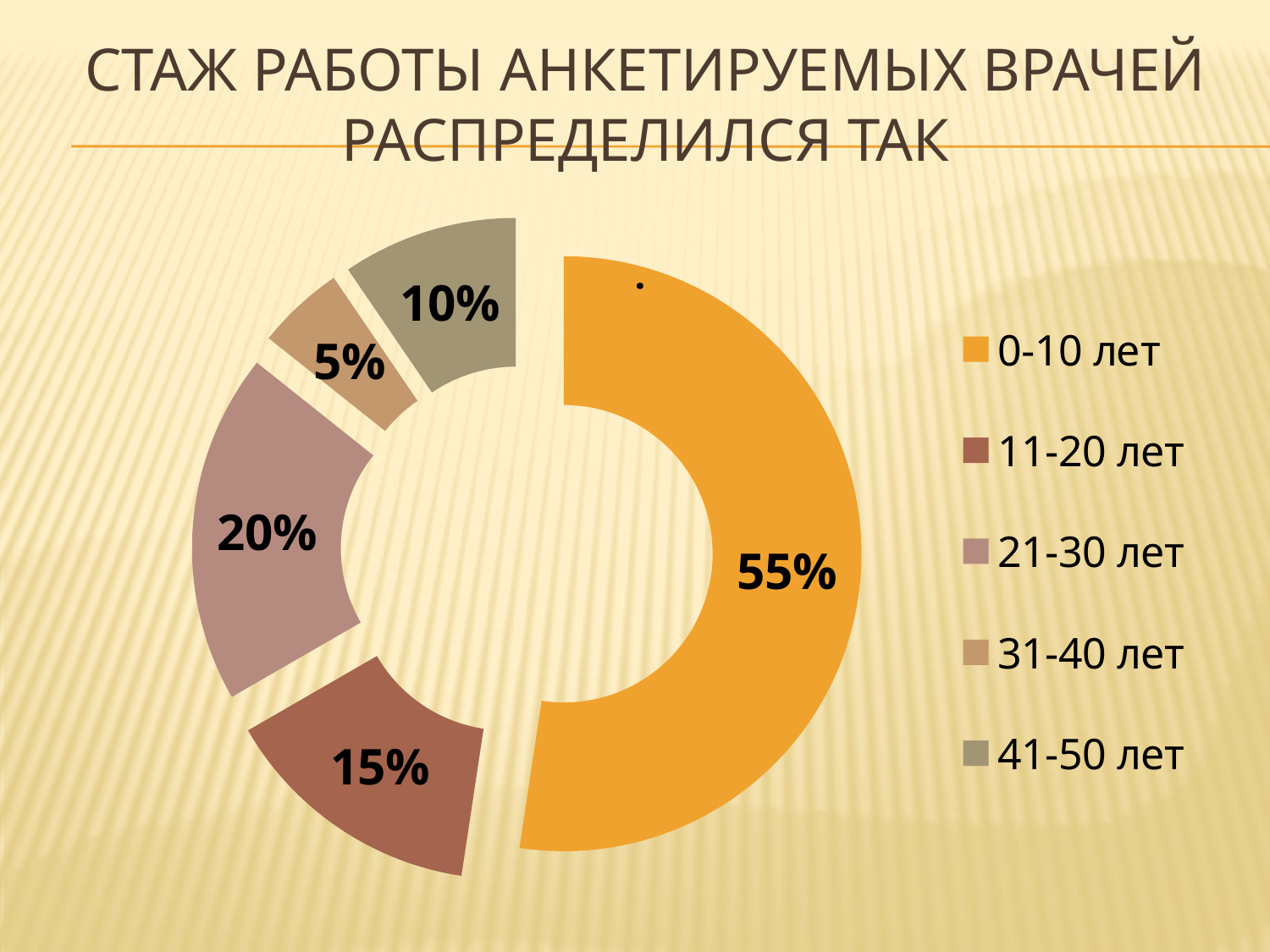
What share of the surveyed doctors have 41-50 лет of work experience? 10% What is the difference in percentage points between the 0-10 лет group and the 21-30 лет group? 35 What share of the surveyed doctors have 31-40 лет of work experience? 5% What type of chart is shown on the slide? Doughnut (pie) chart Which experience group has the smallest share of surveyed doctors? 31-40 лет What share of the surveyed doctors have 21-30 лет of work experience? 20% What share of the surveyed doctors have 11-20 лет of work experience? 15% Which experience group has the largest share of surveyed doctors? 0-10 лет What colour is the slice for the 0-10 лет group? Orange Which group has a larger share: 11-20 лет or 41-50 лет? 11-20 лет What share of the surveyed doctors have 0-10 лет of work experience? 55% How many experience groups are shown in the chart? 5